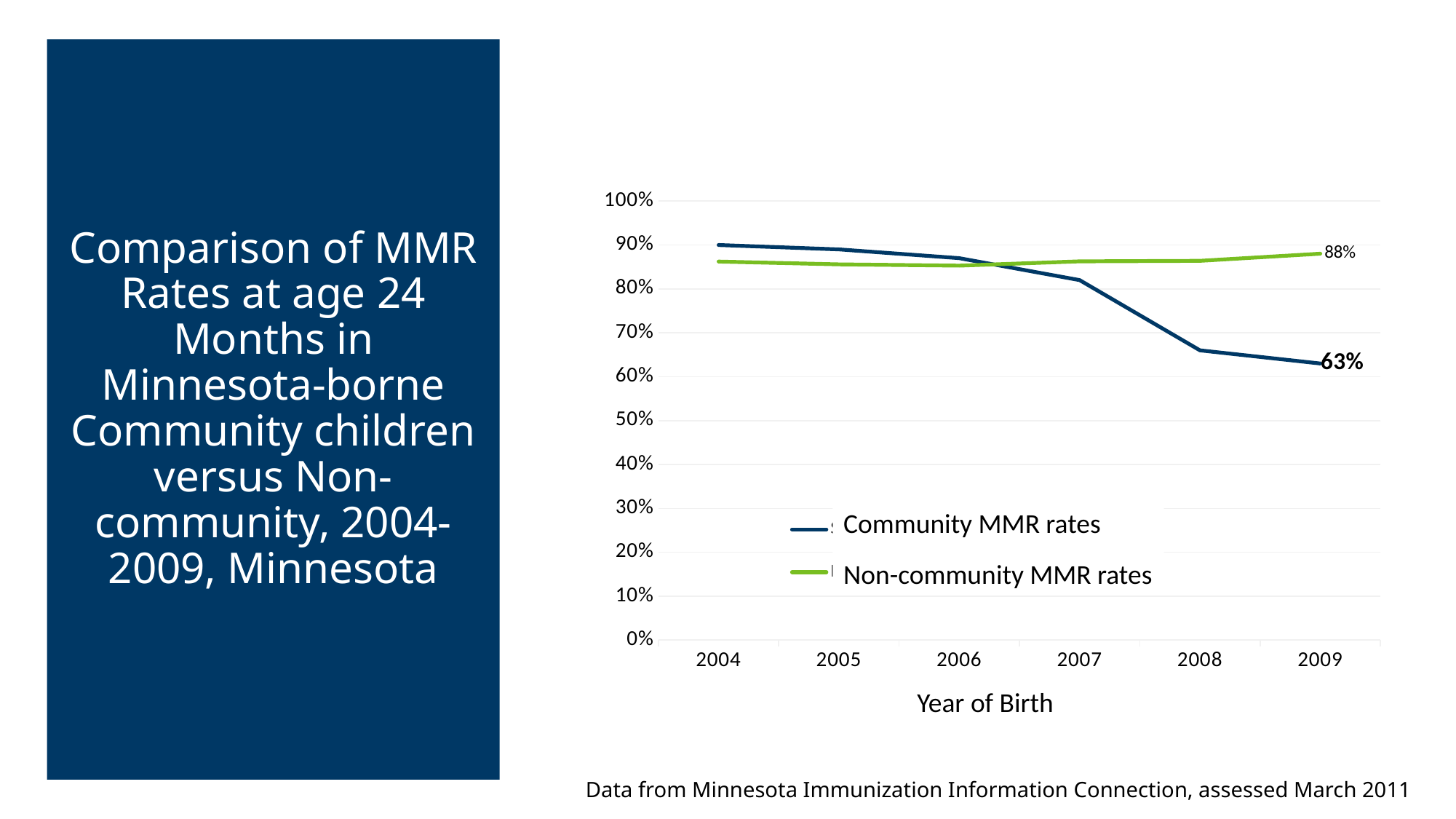
What is the Community MMR rate for the 2009 year of birth? 63% What kind of chart is shown on the slide? line chart Which series has the higher MMR rate for the 2004 year of birth? Community MMR rates How many series does the legend list? 2 Which series has the higher MMR rate for the 2009 year of birth? Non-community MMR rates Is the Community MMR rate for the 2008 year of birth greater or less than 70%? less Does the Community MMR rate rise or fall from 2004 to 2009? fall What is the difference between the Non-community and Community MMR rates for the 2009 year of birth? 25% How many years of birth are shown on the x axis? 6 Is the Community MMR rate for the 2004 year of birth greater or less than 80%? greater Is the Non-community MMR rate for the 2006 year of birth greater or less than 80%? greater What is the Non-community MMR rate for the 2009 year of birth? 88%